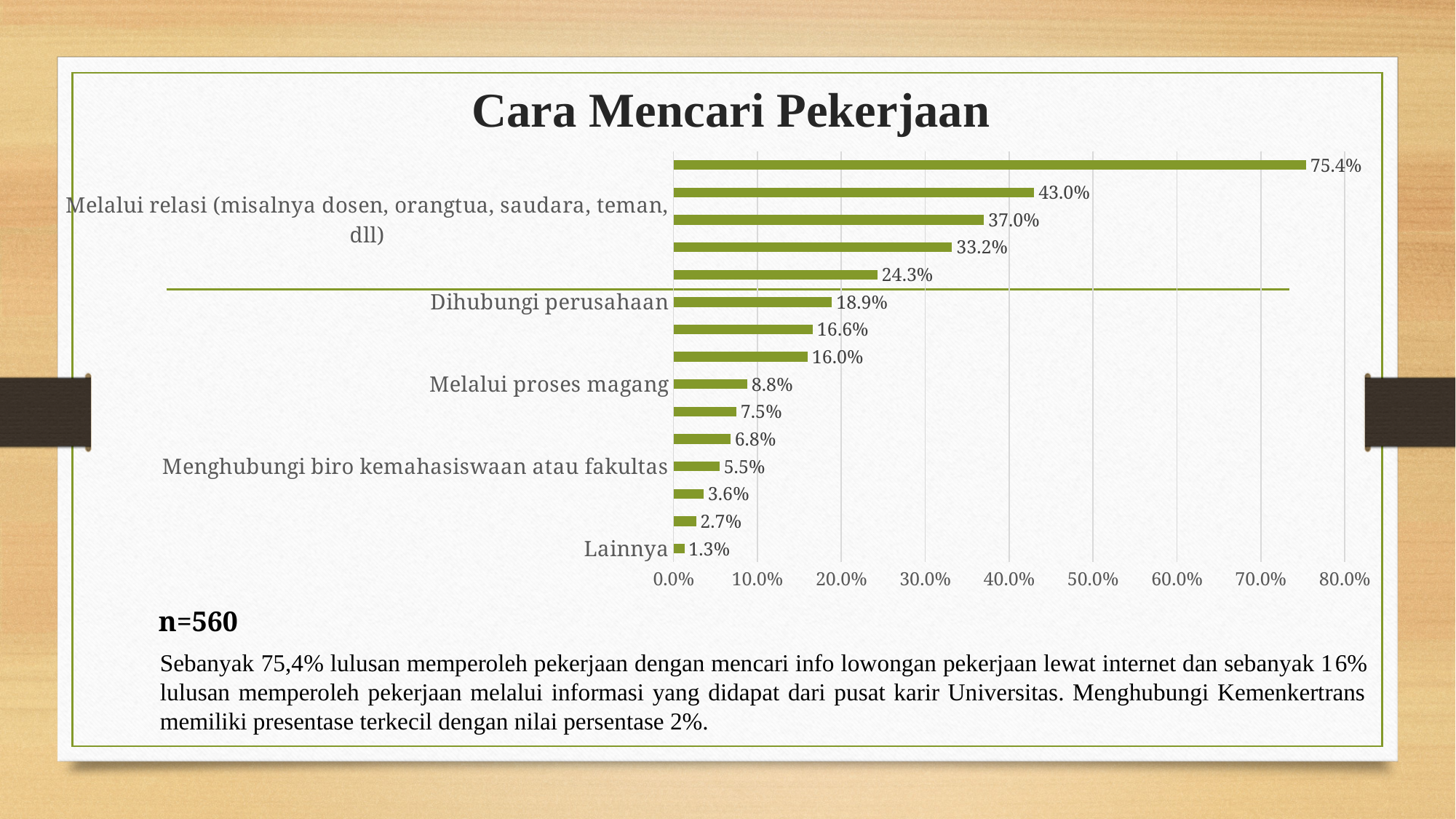
How many bars are plotted in the chart? 15 What is the value for Menghubungi biro kemahasiswaan atau fakultas? 5.5% What is the value for Melalui proses magang? 8.8% What is the title of the chart? Cara Mencari Pekerjaan What is the value for Dihubungi perusahaan? 18.9% Which category has the lowest value in the chart? Lainnya What kind of chart is shown on the slide? Bar chart What is the value for Melalui relasi (misalnya dosen, orangtua, saudara, teman, dll)? 37.0% What is the highest value shown in the chart? 75.4% Which is larger, the value for Melalui relasi (misalnya dosen, orangtua, saudara, teman, dll) or the value for Dihubungi perusahaan? Melalui relasi (misalnya dosen, orangtua, saudara, teman, dll) What is the difference between the values for Dihubungi perusahaan and Melalui proses magang? 10.1% What is the value for Lainnya? 1.3%